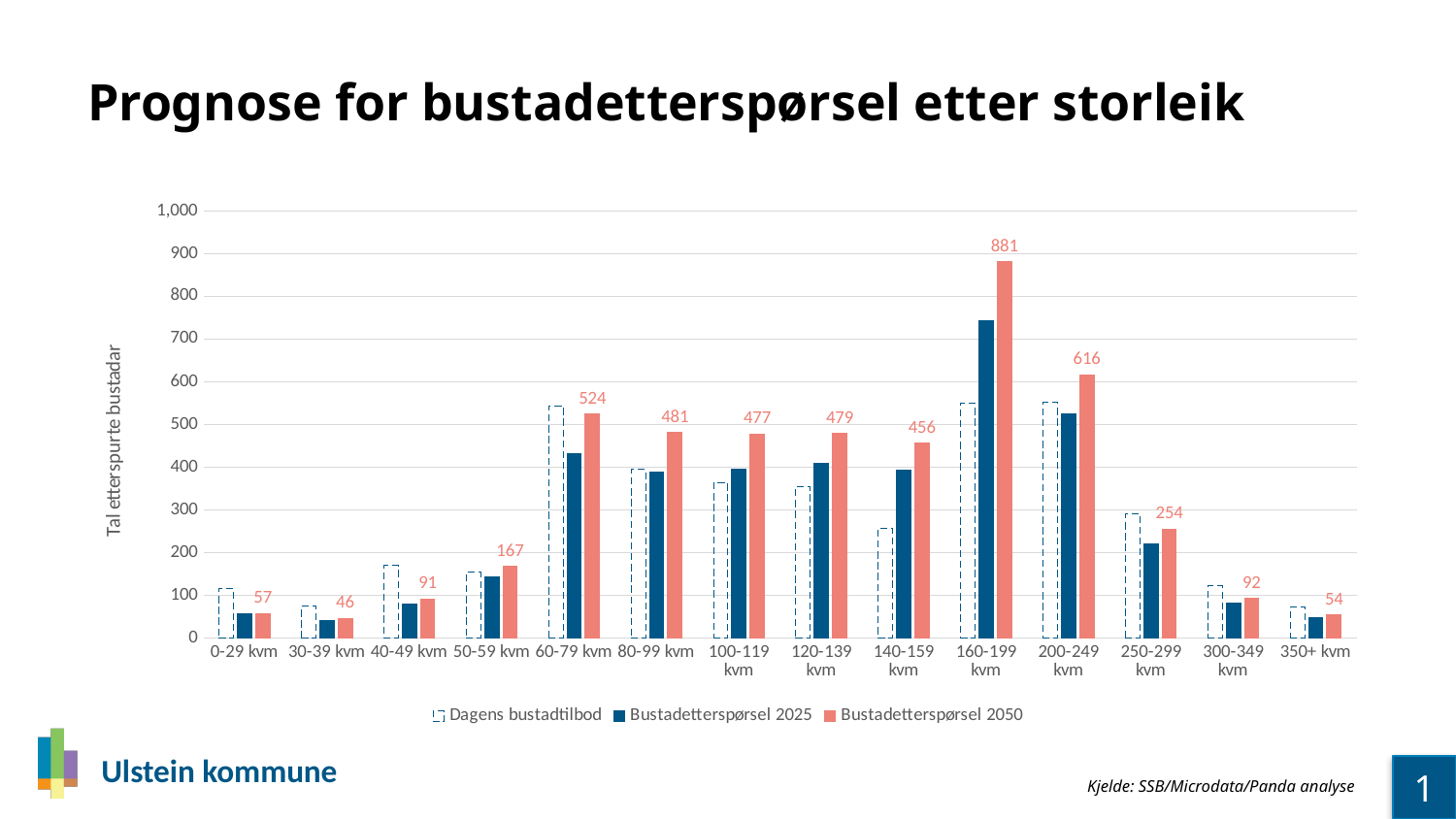
Which size category has the highest Bustadetterspørsel 2050 value? 160-199 kvm What is the Bustadetterspørsel 2050 value for 160-199 kvm? 881 Which is larger, the Bustadetterspørsel 2050 value for 80-99 kvm or for 140-159 kvm? 80-99 kvm Is the Dagens bustadtilbod value for 140-159 kvm greater or less than 300? less Which size category has the lowest Bustadetterspørsel 2050 value? 30-39 kvm What is the Bustadetterspørsel 2050 value for 60-79 kvm? 524 What type of chart is shown on the slide? Bar chart What is the Bustadetterspørsel 2050 value for 30-39 kvm? 46 How many series does the legend list? 3 Is the Bustadetterspørsel 2025 value for 160-199 kvm greater or less than 700? greater How many size categories are shown on the x axis? 14 What is the difference between the Bustadetterspørsel 2050 values for 160-199 kvm and 200-249 kvm? 265